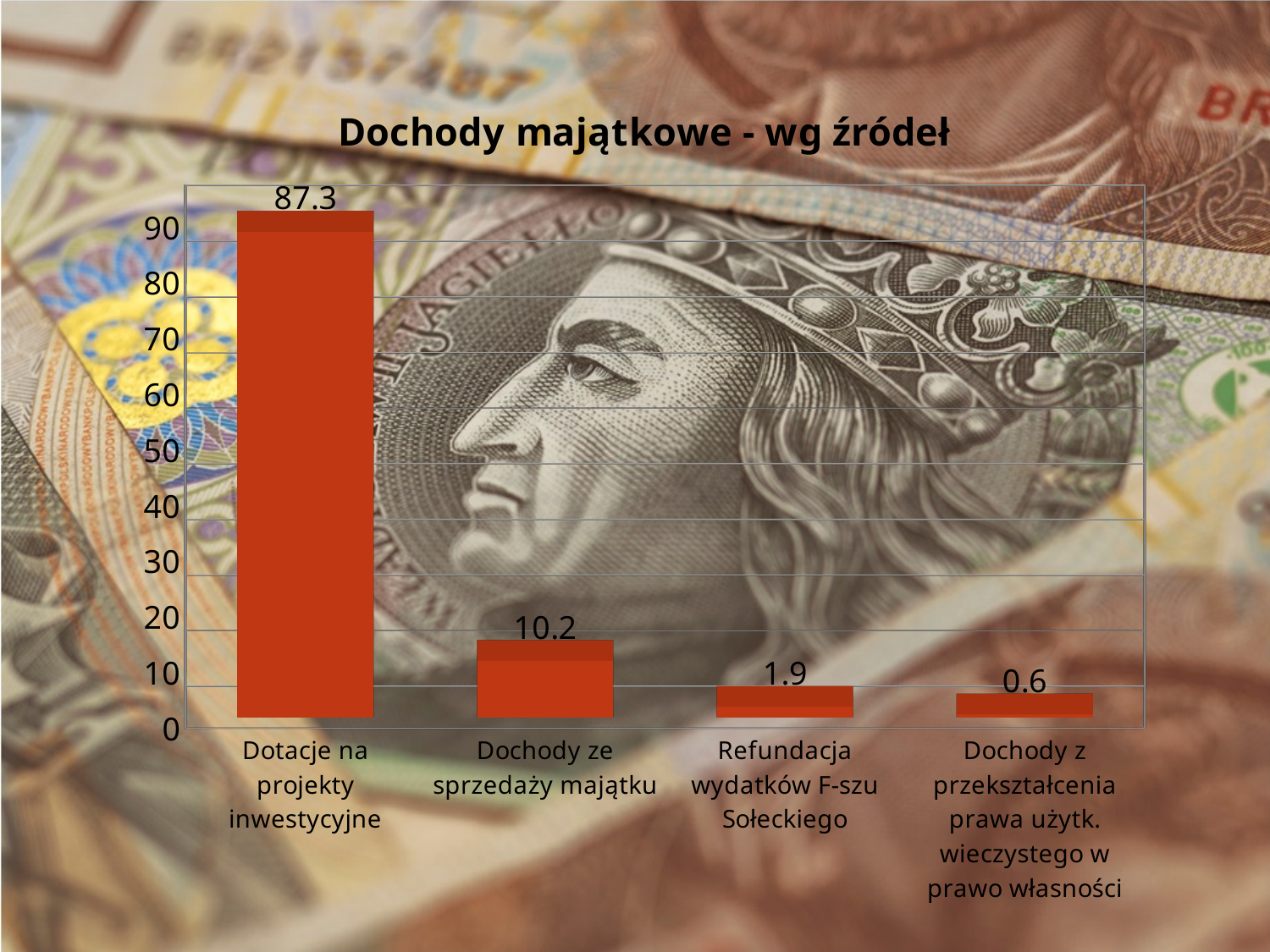
How many categories are shown in the chart? 4 Which is larger: the value for Dochody ze sprzedaży majątku or the value for Refundacja wydatków F-szu Sołeckiego? Dochody ze sprzedaży majątku Which category has the lowest value? Dochody z przekształcenia prawa użytk. wieczystego w prawo własności What is the value for Refundacja wydatków F-szu Sołeckiego? 1.9 Is the value for Dotacje na projekty inwestycyjne greater or less than 80? greater What is the title of the chart? Dochody majątkowe - wg źródeł Which category has the highest value? Dotacje na projekty inwestycyjne What is the value for Dochody z przekształcenia prawa użytk. wieczystego w prawo własności? 0.6 What is the difference between the values for Dotacje na projekty inwestycyjne and Dochody ze sprzedaży majątku? 77.1 What is the value for Dotacje na projekty inwestycyjne? 87.3 What is the value for Dochody ze sprzedaży majątku? 10.2 What kind of chart is shown on the slide? bar chart